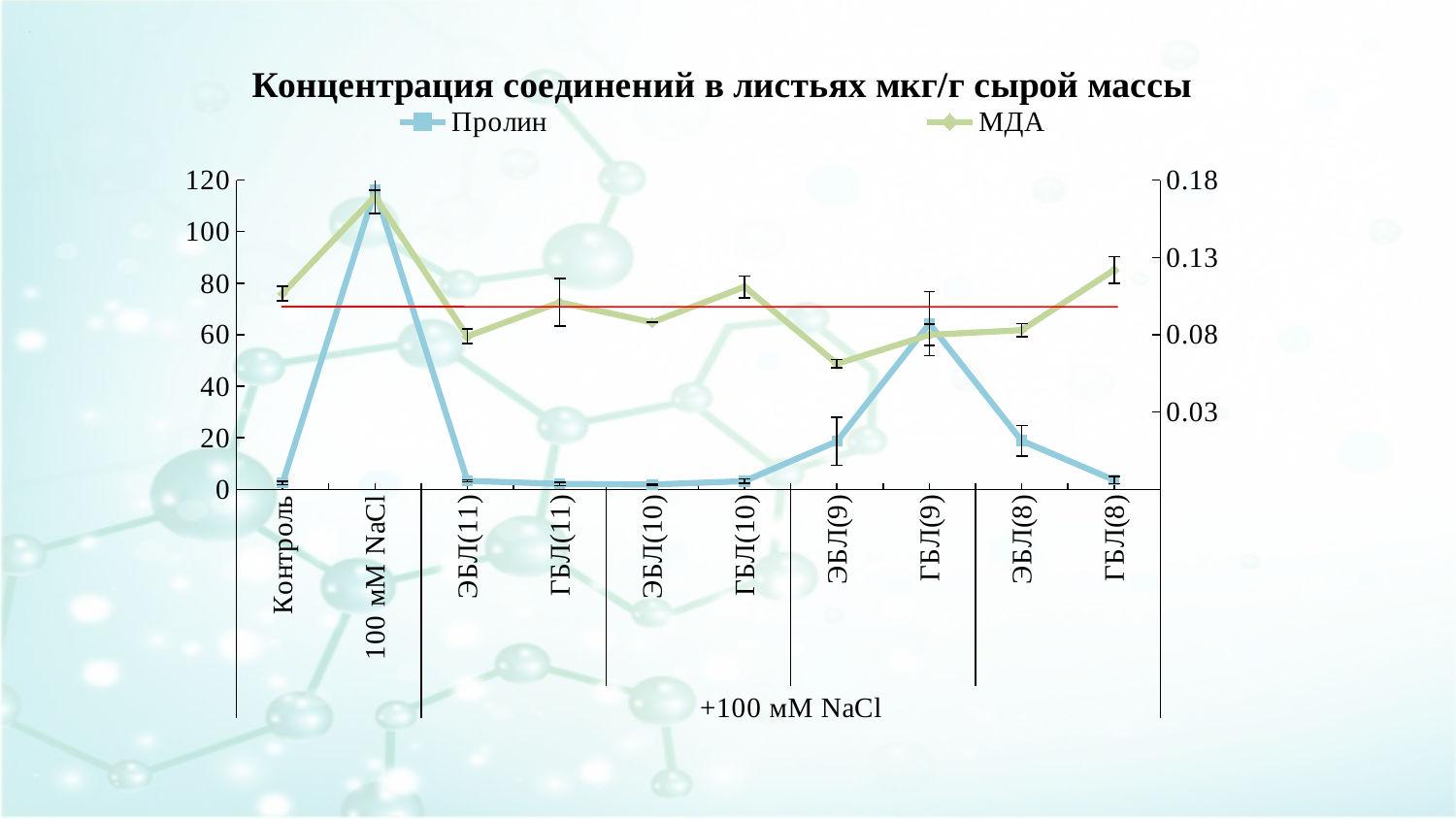
What is the title of the chart? Концентрация соединений в листьях мкг/г сырой массы Is the МДА value for ЭБЛ(9) greater or less than 0.08? less For which category is the МДА value highest? 100 мМ NaCl For which category is the МДА value lowest? ЭБЛ(9) Is the Пролин value for ГБЛ(9) greater or less than 40? greater Which has the larger Пролин value, ЭБЛ(9) or ГБЛ(9)? ГБЛ(9) How many categories are plotted along the x axis? 10 Is the Пролин value for 100 мМ NaCl greater or less than 100? greater What kind of chart is shown on the slide? line chart How many series does the legend list? 2 For which category is the Пролин value highest? 100 мМ NaCl